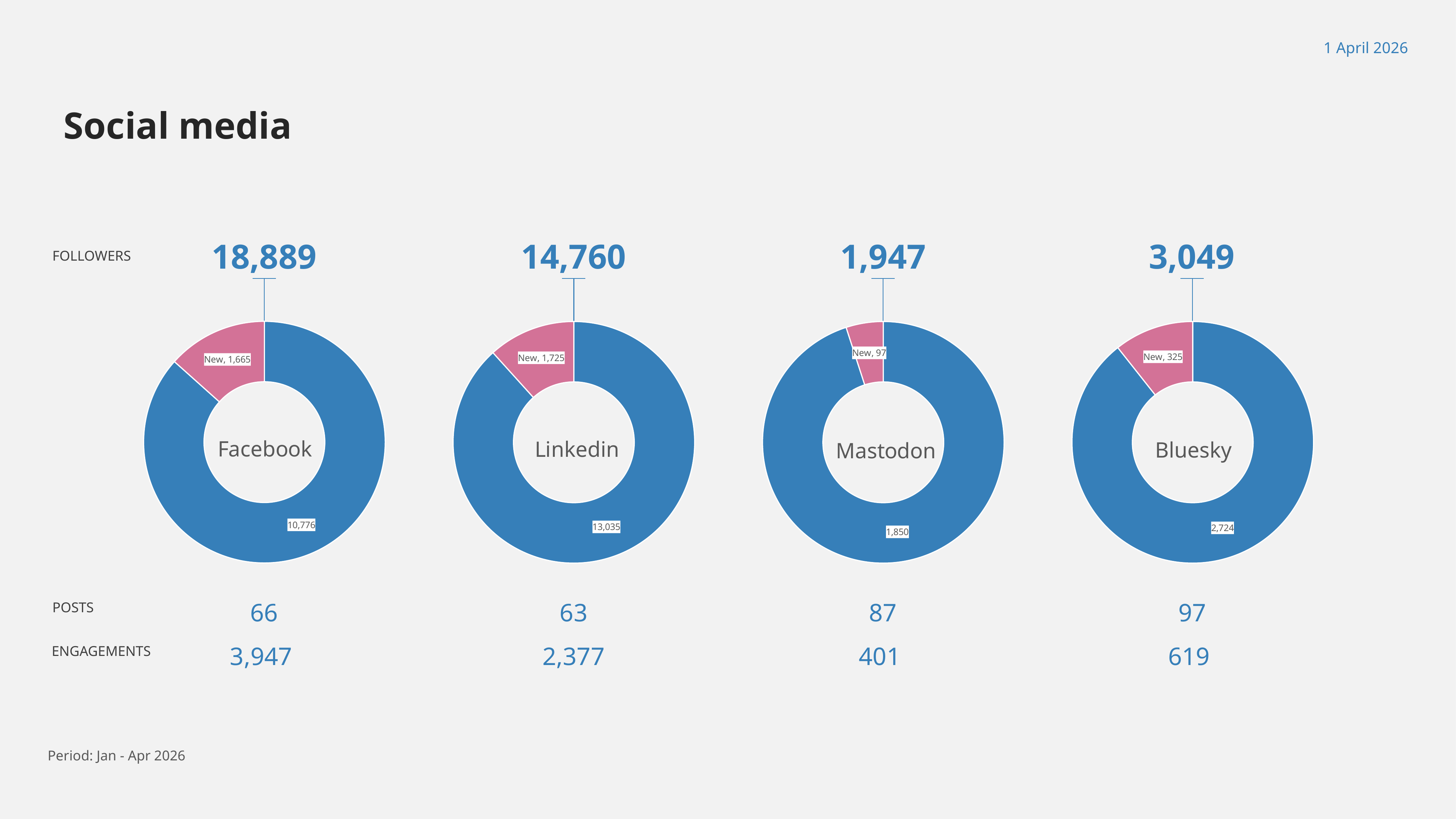
In the Mastodon chart, what is the total of the two slices (1,850 and 97)? 1,947 In the Mastodon chart, what is the value of the 'New' slice? 97 In the Facebook chart, what is the value of the 'New' slice? 1,665 In the Bluesky chart, what is the difference between the blue slice (2,724) and the 'New' slice (325)? 2,399 What colour is used for the 'New' slice in each donut chart? Pink What kind of chart is used for each social media platform on this slide? Pie (donut) chart In the Linkedin chart, what is the value of the larger blue slice? 13,035 In the Linkedin chart, what is the difference between the blue slice (13,035) and the 'New' slice (1,725)? 11,310 In the Bluesky chart, what is the value of the larger blue slice? 2,724 Which of the four charts has the smallest 'New' slice value? Mastodon In the Linkedin chart, which slice is larger, the 'New' slice or the blue slice? The blue slice How many donut charts are shown on the slide? 4